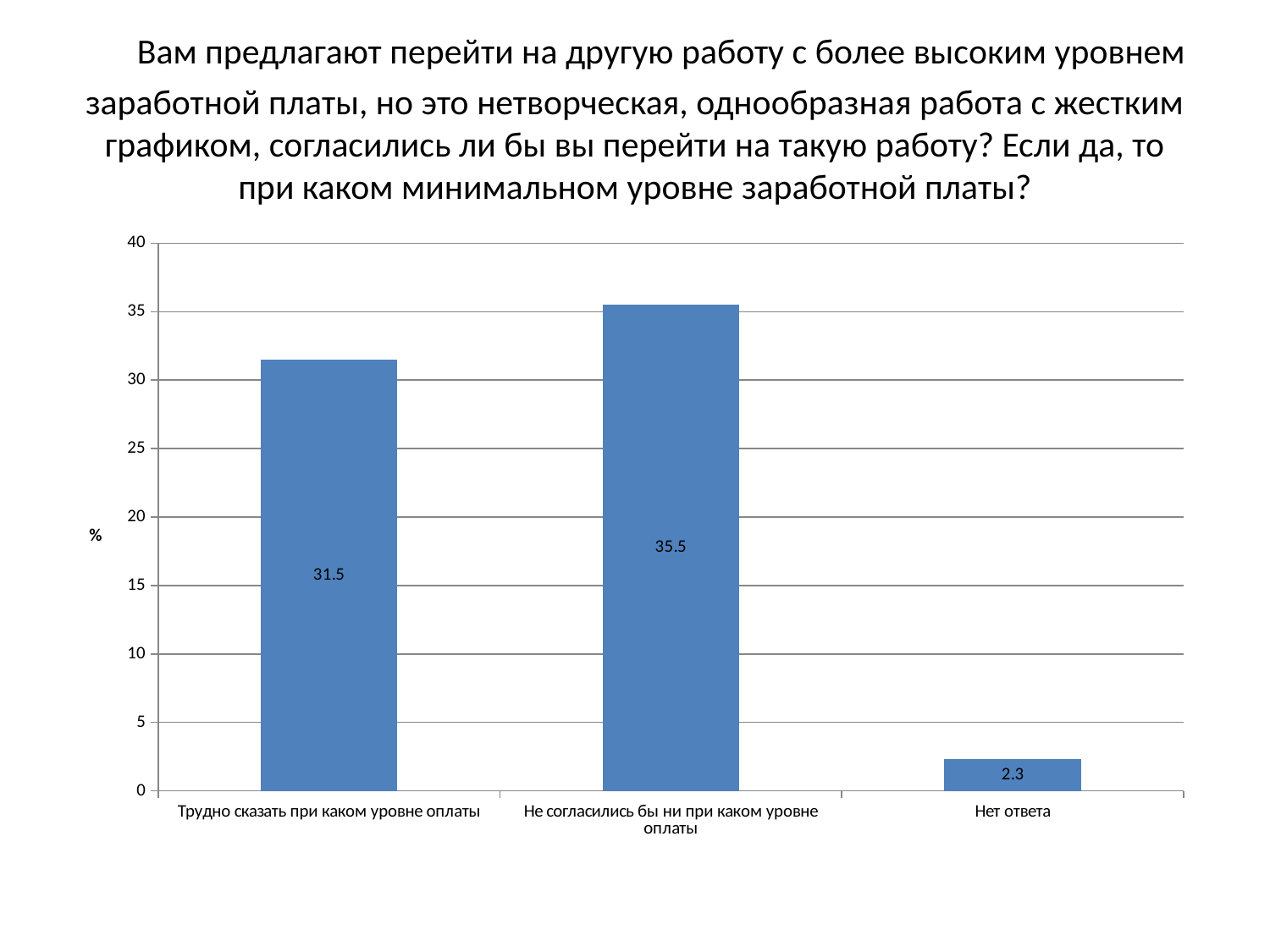
What label is shown on the vertical axis? % What is the difference between the values for "Не согласились бы ни при каком уровне оплаты" and "Трудно сказать при каком уровне оплаты"? 4 How many categories are shown on the x axis? 3 Which is larger: the value for "Трудно сказать при каком уровне оплаты" or the value for "Не согласились бы ни при каком уровне оплаты"? Не согласились бы ни при каком уровне оплаты What is the value for "Трудно сказать при каком уровне оплаты"? 31.5 Is the value for "Трудно сказать при каком уровне оплаты" greater or less than 30? greater What is the value for "Нет ответа"? 2.3 Which category has the highest value? Не согласились бы ни при каком уровне оплаты Which category has the lowest value? Нет ответа What is the value for "Не согласились бы ни при каком уровне оплаты"? 35.5 What is the difference between the values for "Трудно сказать при каком уровне оплаты" and "Нет ответа"? 29.2 What kind of chart is shown on the slide? bar chart